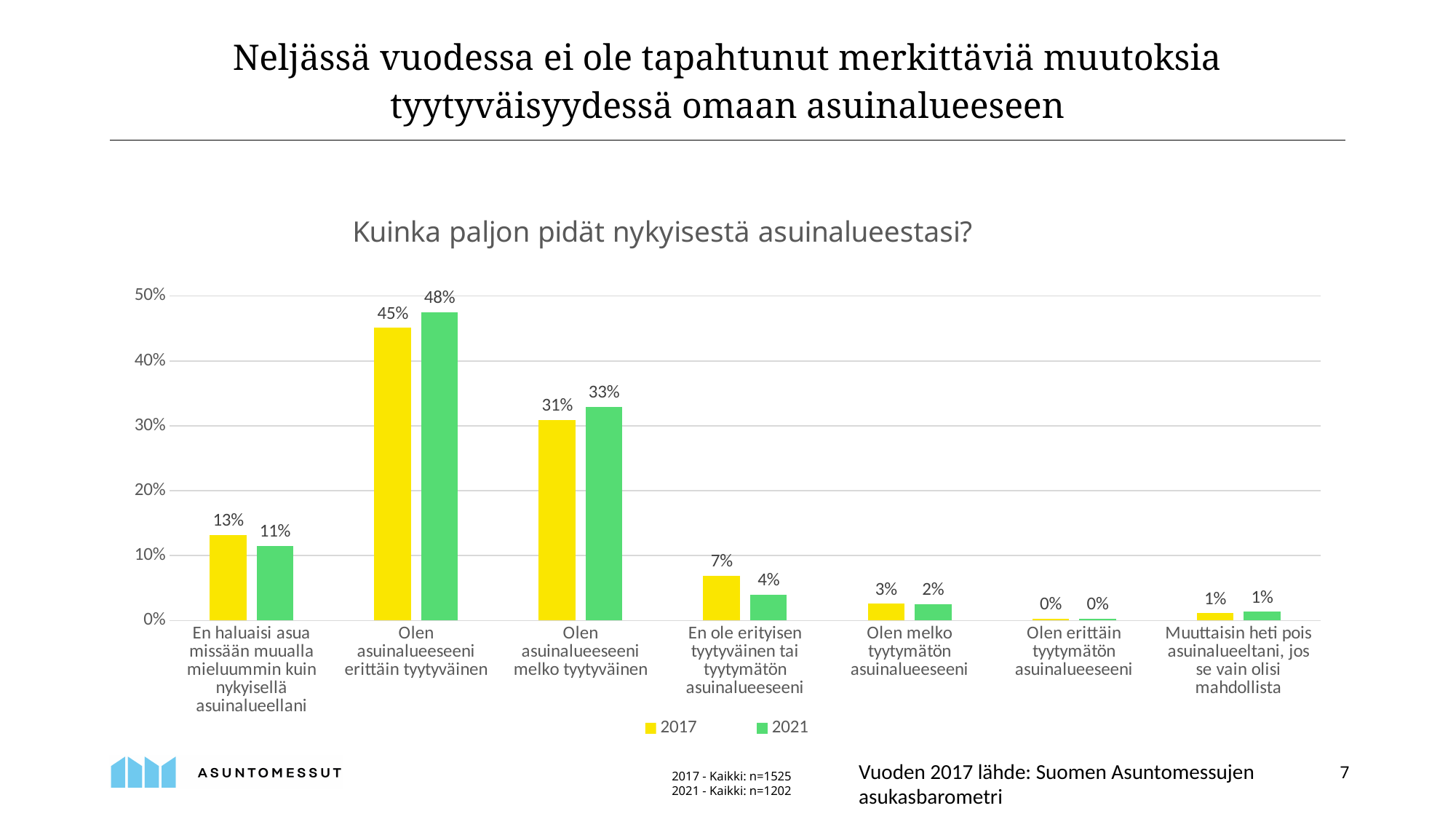
What is the difference between the 2021 and 2017 values for "Olen asuinalueeseeni melko tyytyväinen"? 2% What is the 2021 value for "Olen asuinalueeseeni erittäin tyytyväinen"? 48% What is the 2021 value for "En ole erityisen tyytyväinen tai tyytymätön asuinalueeseeni"? 4% For "En ole erityisen tyytyväinen tai tyytymätön asuinalueeseeni", which year has the larger value, 2017 or 2021? 2017 Which category has the highest 2017 value? Olen asuinalueeseeni erittäin tyytyväinen Which category has the lowest 2021 value? Olen erittäin tyytymätön asuinalueeseeni How many series does the legend list? 2 How many categories are shown on the x axis? 7 What is the title of the chart? Kuinka paljon pidät nykyisestä asuinalueestasi? Is the 2017 value for "Olen asuinalueeseeni erittäin tyytyväinen" greater or less than 40%? greater What is the 2017 value for "En haluaisi asua missään muualla mieluummin kuin nykyisellä asuinalueellani"? 13% What kind of chart is shown on the slide? Bar chart